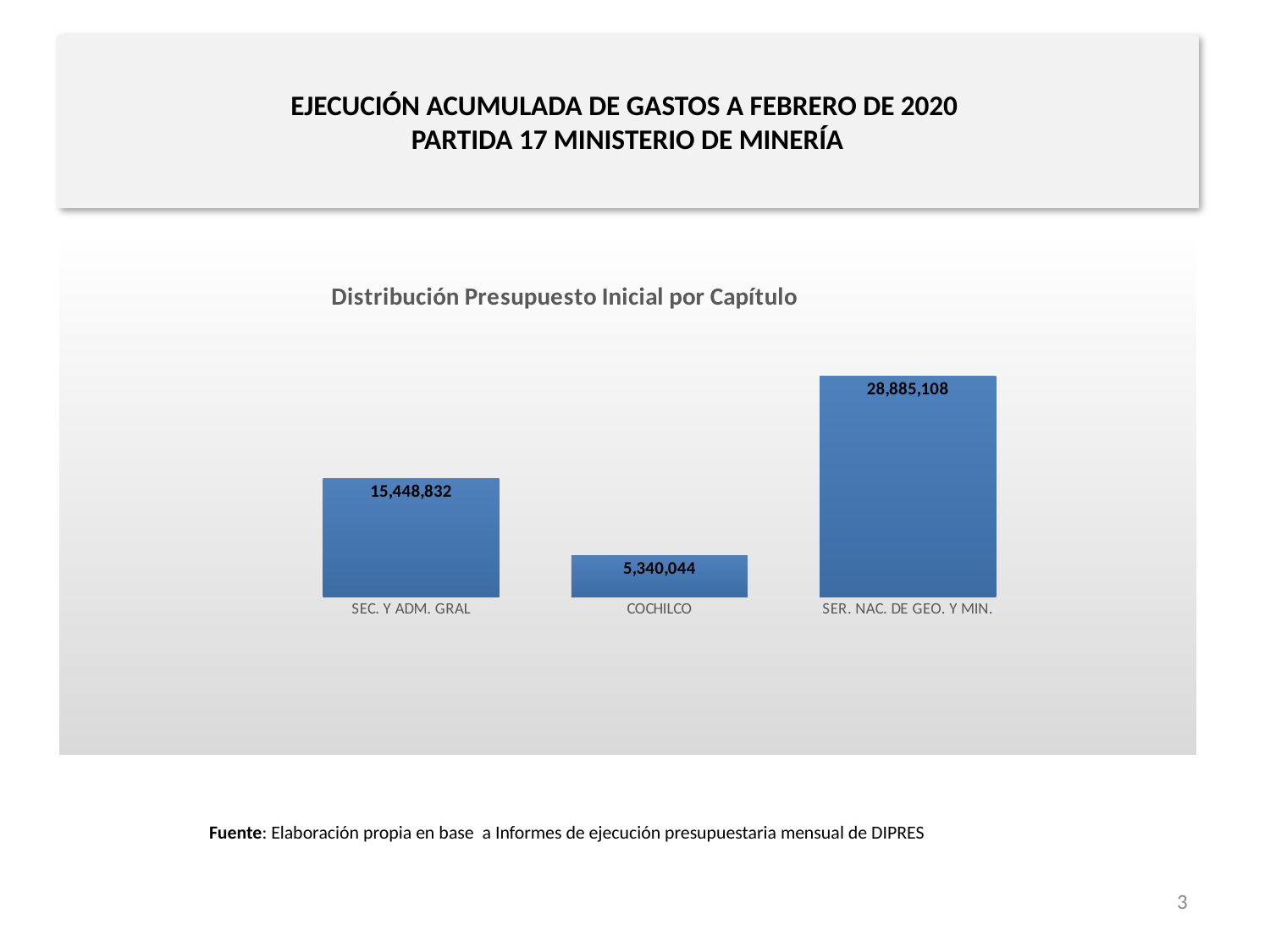
What is the value for COCHILCO in the chart? 5,340,044 Which is larger, the value for SEC. Y ADM. GRAL or the value for COCHILCO? SEC. Y ADM. GRAL What is the difference between the values for SER. NAC. DE GEO. Y MIN. and COCHILCO? 23,545,064 What is the value for SEC. Y ADM. GRAL in the chart? 15,448,832 What kind of chart is shown on the slide? Bar chart What is the value for SER. NAC. DE GEO. Y MIN. in the chart? 28,885,108 How many categories are shown in the chart? 3 What is the title of the chart? Distribución Presupuesto Inicial por Capítulo Which category has the lowest value in the chart? COCHILCO Which category has the highest value in the chart? SER. NAC. DE GEO. Y MIN. What is the difference between the values for SEC. Y ADM. GRAL and COCHILCO? 10,108,788 What is the difference between the values for SER. NAC. DE GEO. Y MIN. and SEC. Y ADM. GRAL? 13,436,276